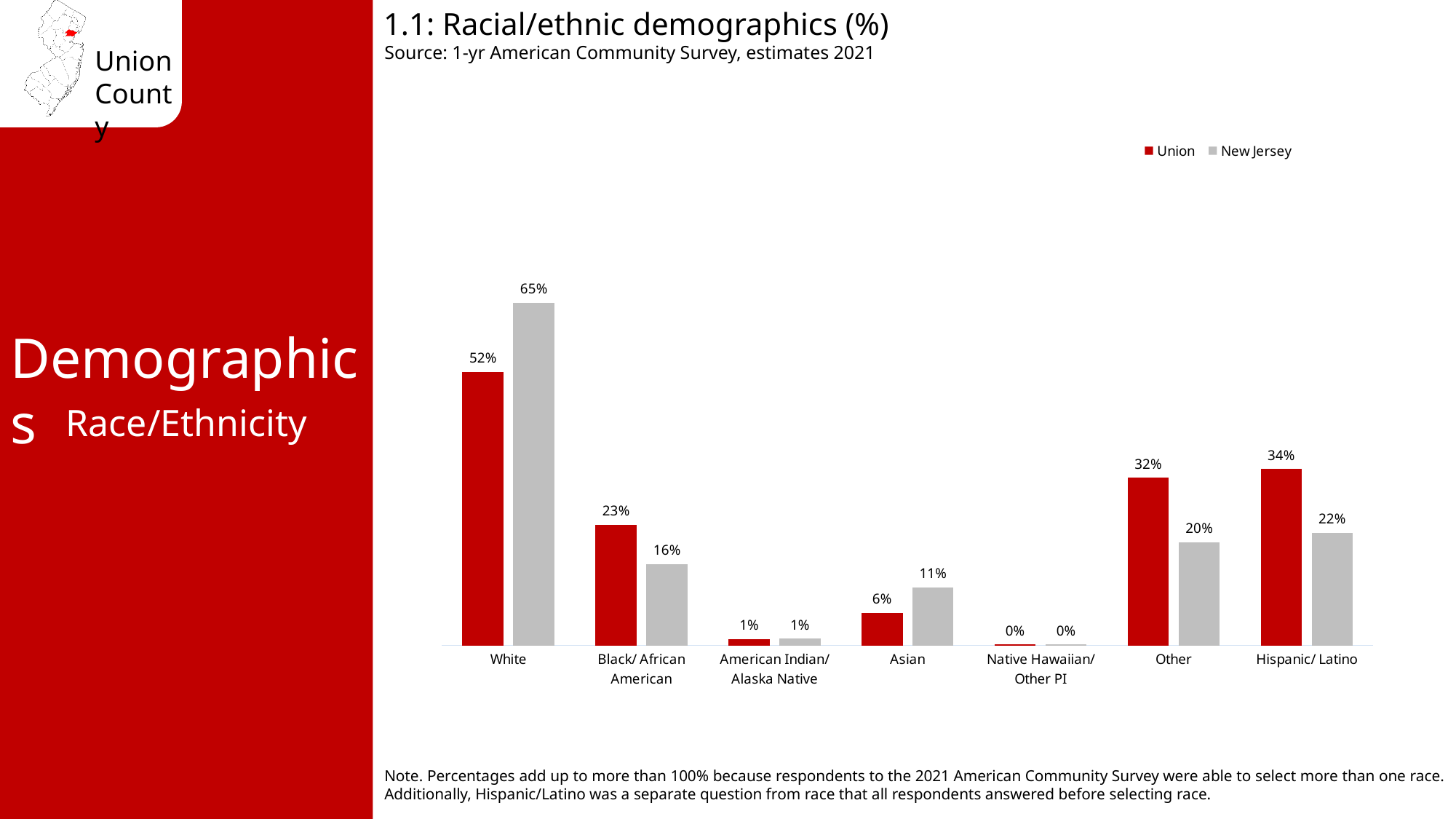
Which category has the highest New Jersey value? White What is the Union value for White? 52% How many categories are shown on the x axis? 7 What is the Union value for Asian? 6% What is the New Jersey value for Hispanic/ Latino? 22% Which is larger for Asian, the Union value or the New Jersey value? New Jersey Which category has the lowest Union value? Native Hawaiian/ Other PI What is the difference between the New Jersey and Union values for White? 13% What is the difference between the Union and New Jersey values for Other? 12% What kind of chart is this? Bar chart How many series does the legend list? 2 Which is larger for Black/ African American, the Union value or the New Jersey value? Union